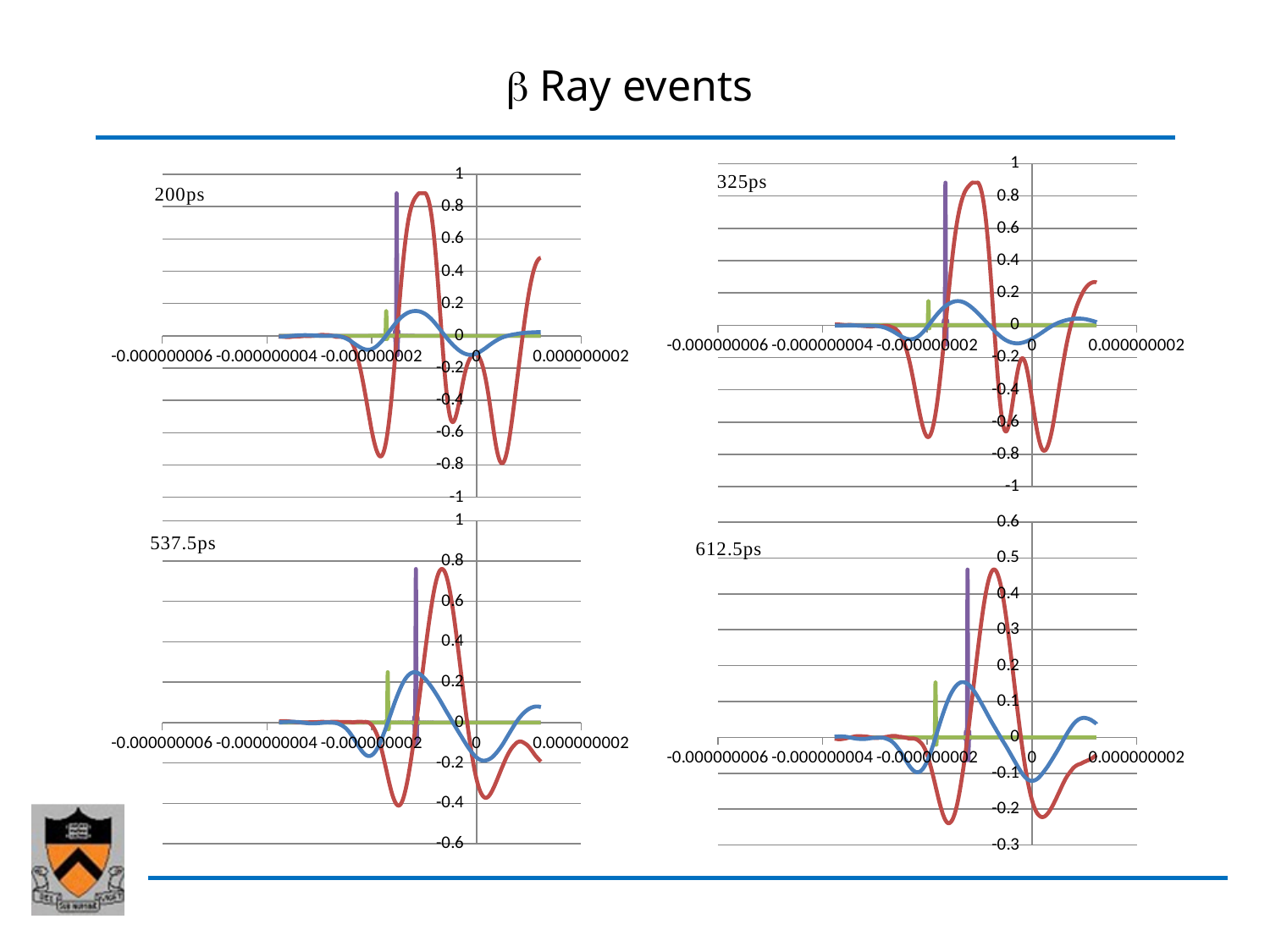
In the 537.5ps chart, is the highest value of the red line greater or less than 0.6? greater What kind of chart is the 200ps chart? line chart In the 325ps chart, is the peak of the blue line greater or less than 0.4? less What is the highest value shown on the y axis of the 612.5ps chart? 0.6 In the 537.5ps chart, which line reaches a lower minimum, the red line or the blue line? red In the 612.5ps chart, is the lowest value of the red line greater or less than -0.2? less In the 612.5ps chart, which line reaches a higher peak, the red line or the blue line? red How many charts are shown on the slide? 4 What is the lowest value shown on the y axis of the 537.5ps chart? -0.6